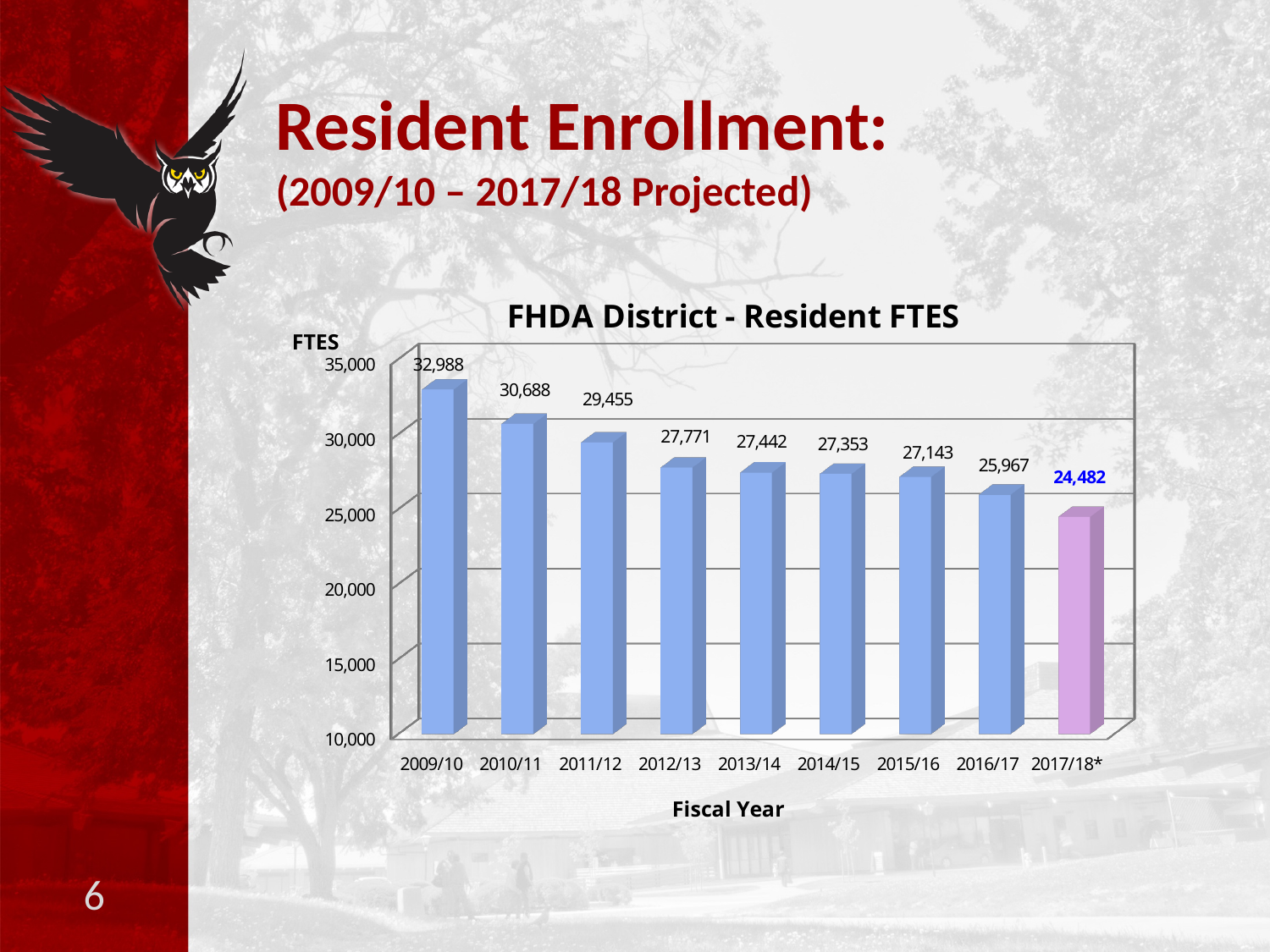
How many fiscal years are shown on the chart? 9 What is the resident FTES value for 2013/14? 27,442 Is the resident FTES value for 2015/16 greater or less than 25,000? greater What is the resident FTES value for 2017/18*? 24,482 What kind of chart is shown on the slide? Bar chart Which fiscal year has the highest resident FTES? 2009/10 Which fiscal year has the lowest resident FTES? 2017/18* What is the difference in resident FTES between 2016/17 and 2017/18*? 1,485 What is the difference in resident FTES between 2009/10 and 2010/11? 2,300 What is the resident FTES value for 2009/10? 32,988 Do the resident FTES values rise or fall from 2009/10 to 2017/18*? Fall Which has a higher resident FTES, 2011/12 or 2012/13? 2011/12